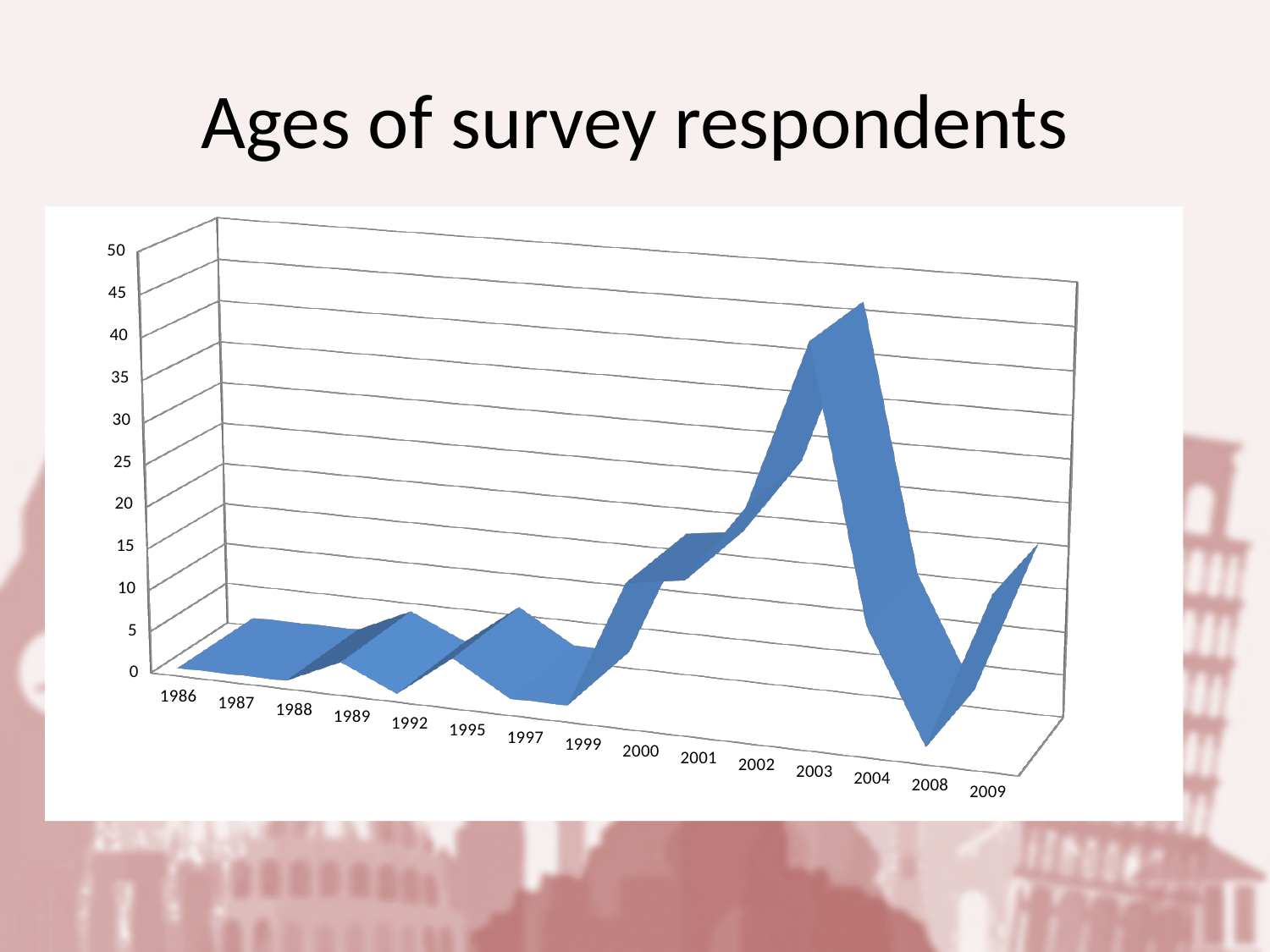
Is the value for 2008 greater or less than 5? less Do the values rise or fall from 2003 to 2008? fall Which is larger, the value for 2002 or the value for 1999? 2002 Do the values rise or fall from 2000 to 2003? rise What kind of chart is shown on the slide? line chart Is the value for 1986 greater or less than 10? less Is the value for 2003 greater or less than 30? greater How many categories are shown along the x axis of the chart? 15 What is the title of the chart? Ages of survey respondents Which is larger, the value for 2003 or the value for 2004? 2003 Which category has the highest value in the chart? 2003